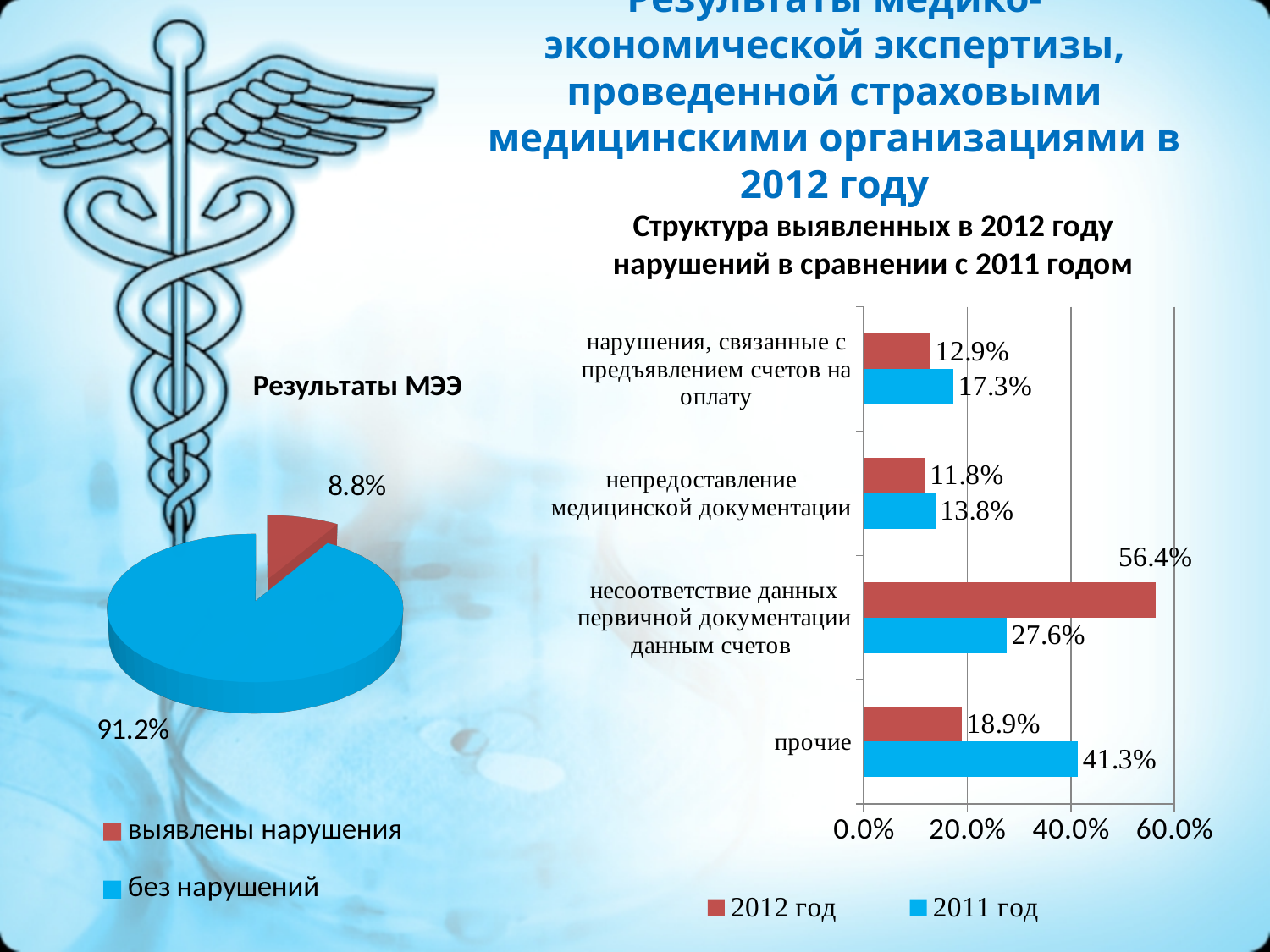
In the bar chart on the right, which category has the highest 2012 год value? несоответствие данных первичной документации данным счетов In the bar chart on the right, what is the difference between the 2011 год and 2012 год values for 'прочие'? 22.4% In the pie chart 'Результаты МЭЭ', what share is labelled 'без нарушений'? 91.2% How many series does the legend of the bar chart on the right list? 2 In the bar chart on the right, what is the 2011 год value for 'прочие'? 41.3% How many categories are shown in the bar chart on the right? 4 In the bar chart on the right, what is the 2011 год value for 'непредоставление медицинской документации'? 13.8% What kind of chart is 'Результаты МЭЭ' on the left of the slide? pie chart In the bar chart on the right, what is the 2012 год value for 'несоответствие данных первичной документации данным счетов'? 56.4% In the bar chart on the right, which is larger for 'нарушения, связанные с предъявлением счетов на оплату': the 2012 год value or the 2011 год value? 2011 год In the bar chart on the right, which category has the lowest 2011 год value? непредоставление медицинской документации In the pie chart 'Результаты МЭЭ', what share is labelled 'выявлены нарушения'? 8.8%